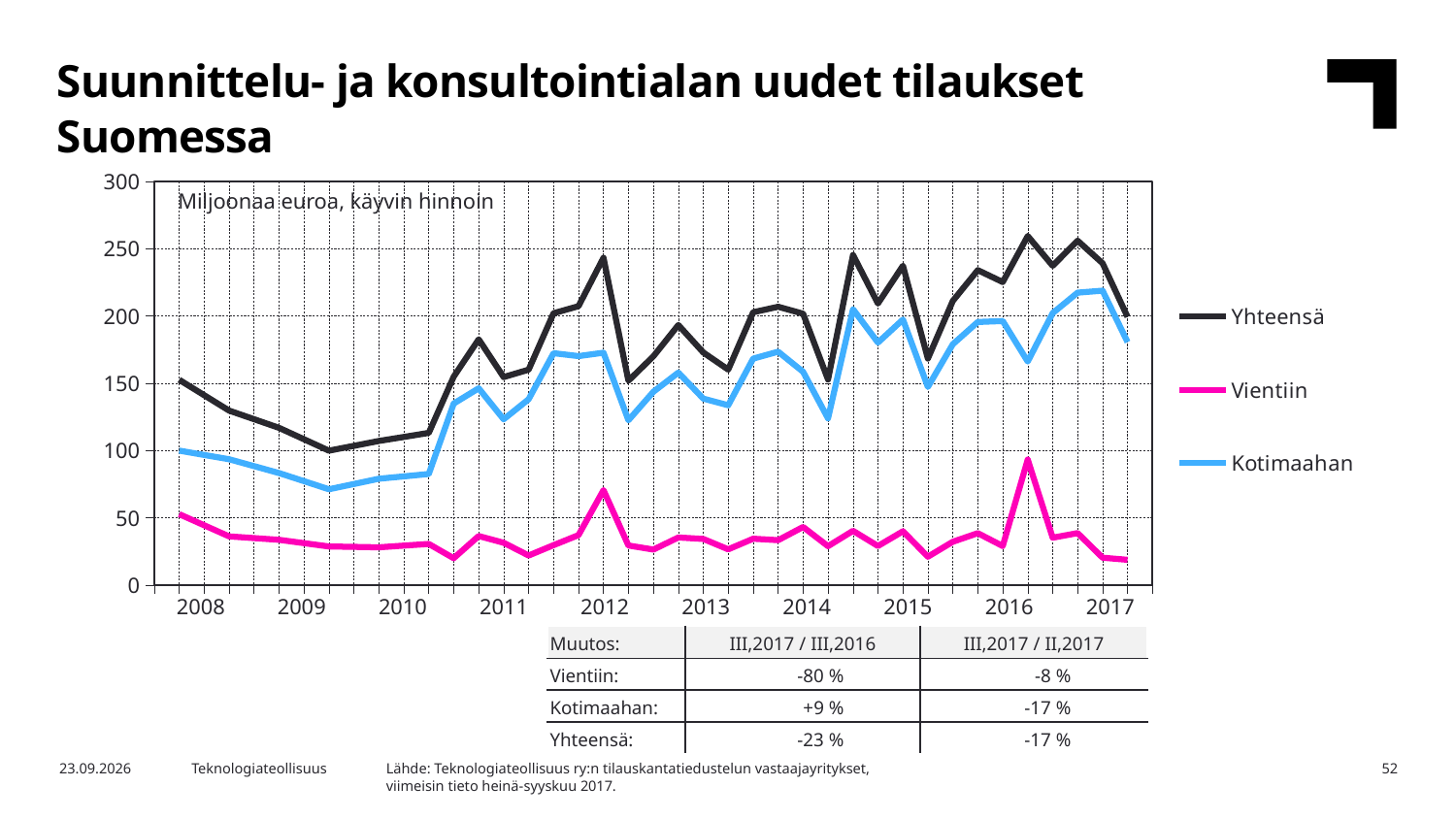
What unit label is printed inside the chart area? Miljoonaa euroa, käyvin hinnoin What kind of chart is shown on the slide? line chart How many series does the legend list? 3 How many year labels are shown on the x axis? 10 Which series has the highest values throughout the chart? Yhteensä Is the peak value of the Yhteensä line around 2016 greater or less than 250? greater Does the Yhteensä line generally rise or fall from 2008 to 2017? rise At the 2016 peak of the Vientiin line, which is larger: Vientiin or Kotimaahan? Kotimaahan Which series has the lowest values throughout the chart? Vientiin Is the value of the Kotimaahan line at the start of 2009 greater or less than 100? less What are the three series named in the legend? Yhteensä, Vientiin, Kotimaahan Is the last value of the Vientiin line in 2017 greater or less than 50? less